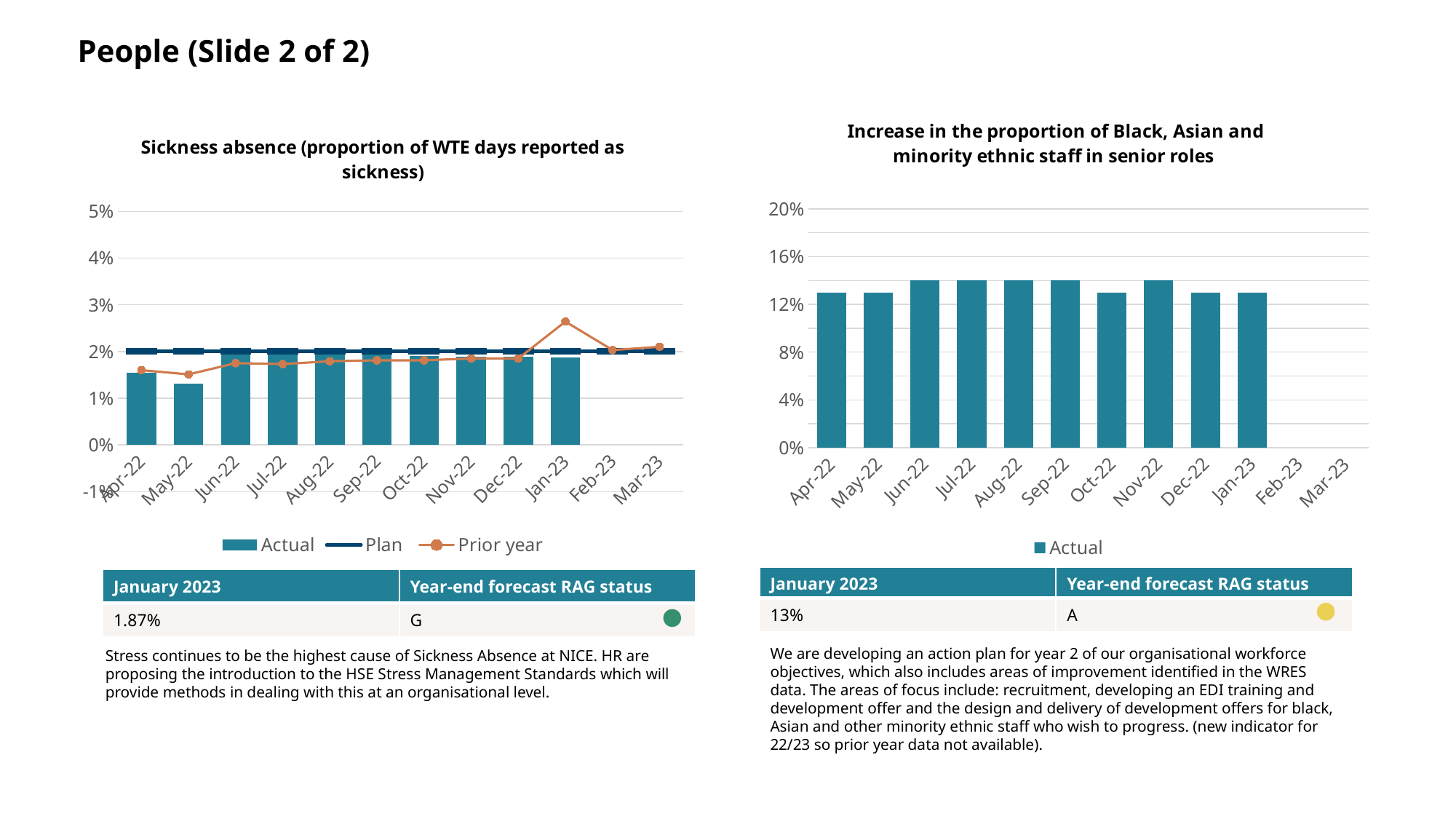
In the right-hand chart, is the value for Nov-22 greater or less than 16%? less In the right-hand chart, is the value for Apr-22 greater or less than 12%? greater In the left-hand chart, which month has the lowest Actual bar? May-22 How many series does the legend of the left-hand chart, 'Sickness absence', list? 3 What is the year-end forecast RAG status shown in the table below the right-hand chart? A What kind of chart is the right-hand chart, 'Increase in the proportion of Black, Asian and minority ethnic staff in senior roles'? Bar chart In the left-hand chart, which month has the highest Prior year value? Jan-23 How many series does the legend of the right-hand chart list? 1 In the left-hand chart, is the Actual value for May-22 greater or less than 2%? less In the right-hand chart, which is larger, the bar for Jun-22 or the bar for Oct-22? Jun-22 In the right-hand chart, how many months have a bar plotted? 10 According to the table below the left-hand chart, what is the January 2023 sickness absence value? 1.87%